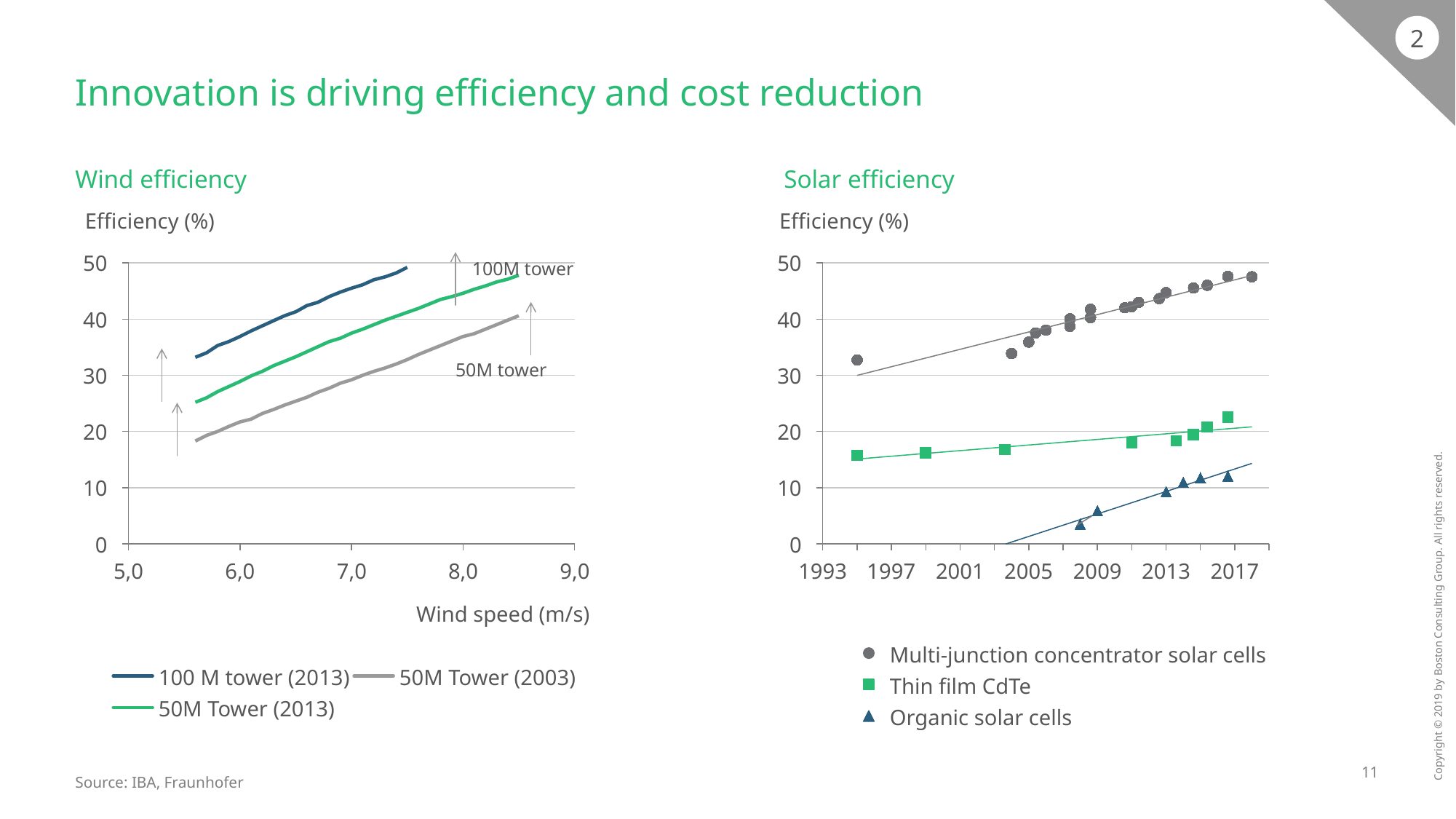
In the Wind efficiency chart, at a wind speed of 7,0 m/s, which has the higher efficiency: the 100 M tower (2013) or the 50M Tower (2003)? 100 M tower (2013) In the Wind efficiency chart, does efficiency rise or fall as wind speed increases? rise In the Wind efficiency chart, is the efficiency of the 100 M tower (2013) at a wind speed of 6,0 m/s greater or less than 30? greater How many series does the legend of the Wind efficiency chart list? 3 In the Solar efficiency chart, does the efficiency of multi-junction concentrator solar cells rise or fall over the years? rise What kind of chart is the Wind efficiency chart? line chart How many series does the legend of the Solar efficiency chart list? 3 In the Solar efficiency chart, which series has the highest efficiency values? Multi-junction concentrator solar cells In the Wind efficiency chart, is the efficiency of the 50M Tower (2003) at a wind speed of 8,0 m/s greater or less than 30? greater What is the x-axis label of the Wind efficiency chart? Wind speed (m/s) In the Solar efficiency chart, is the efficiency of organic solar cells in 2009 greater or less than 10? less What kind of chart is the Solar efficiency chart? scatter chart